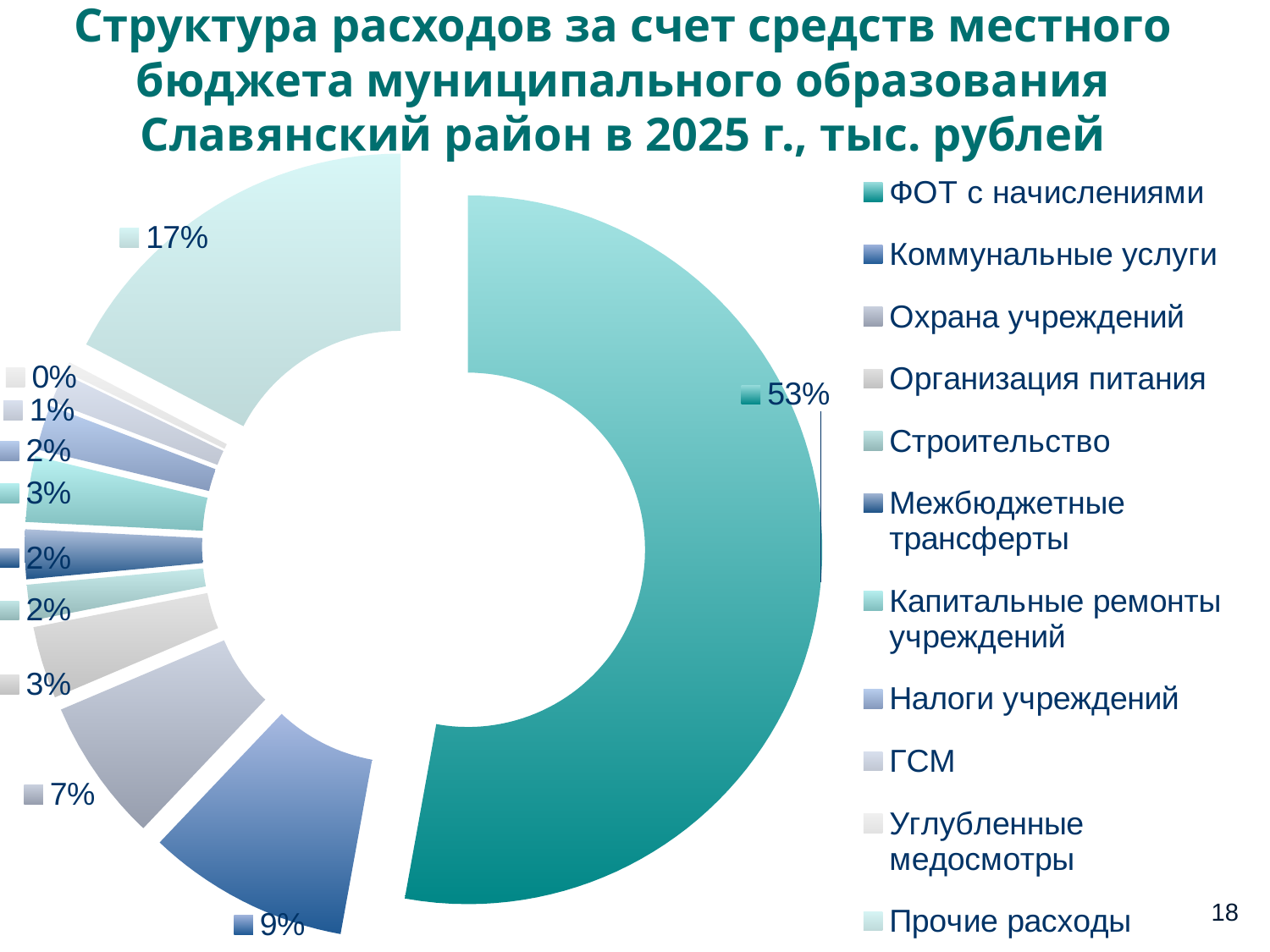
Which category has the largest share of expenditures? ФОТ с начислениями What share is shown for Коммунальные услуги? 9% What share of expenditures does ФОТ с начислениями account for? 53% What percentage is shown for ГСМ? 1% What type of chart is shown on the slide? Pie (doughnut) chart Which has a larger share: Коммунальные услуги or Охрана учреждений? Коммунальные услуги How many categories are listed in the legend? 11 What percentage is shown for Охрана учреждений? 7% What percentage is shown for Прочие расходы? 17% Which category has the smallest share of expenditures? Углубленные медосмотры What is the difference in percentage points between ФОТ с начислениями and Прочие расходы? 36 percentage points For which year does the chart show the expenditure structure? 2025